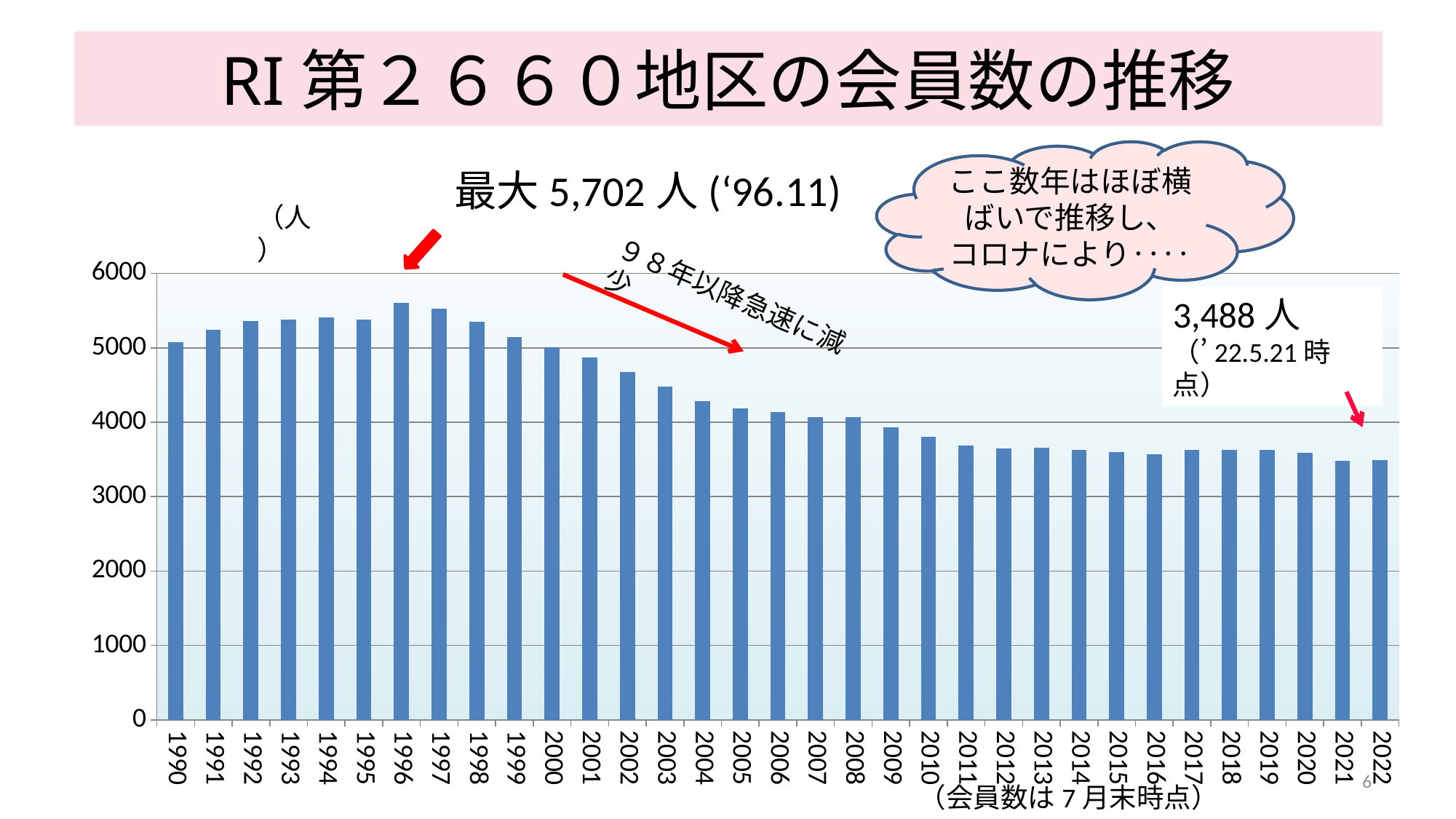
Which is larger, the value for 1999 or the value for 2003? 1999 Which year has the highest bar on the chart? 1996 What kind of chart is shown on the slide? bar chart Is the value for 2002 greater or less than 4000? greater How many years (bars) are plotted on the chart? 33 Is the value for 2022 greater or less than 4000? less Do the values generally rise or fall from 1996 to 2022? fall According to the annotation on the slide, what was the maximum membership and when was it reached? 5,702人 ('96.11) Is the value for 2010 greater or less than 4000? less Which is larger, the value for 1990 or the value for 2022? 1990